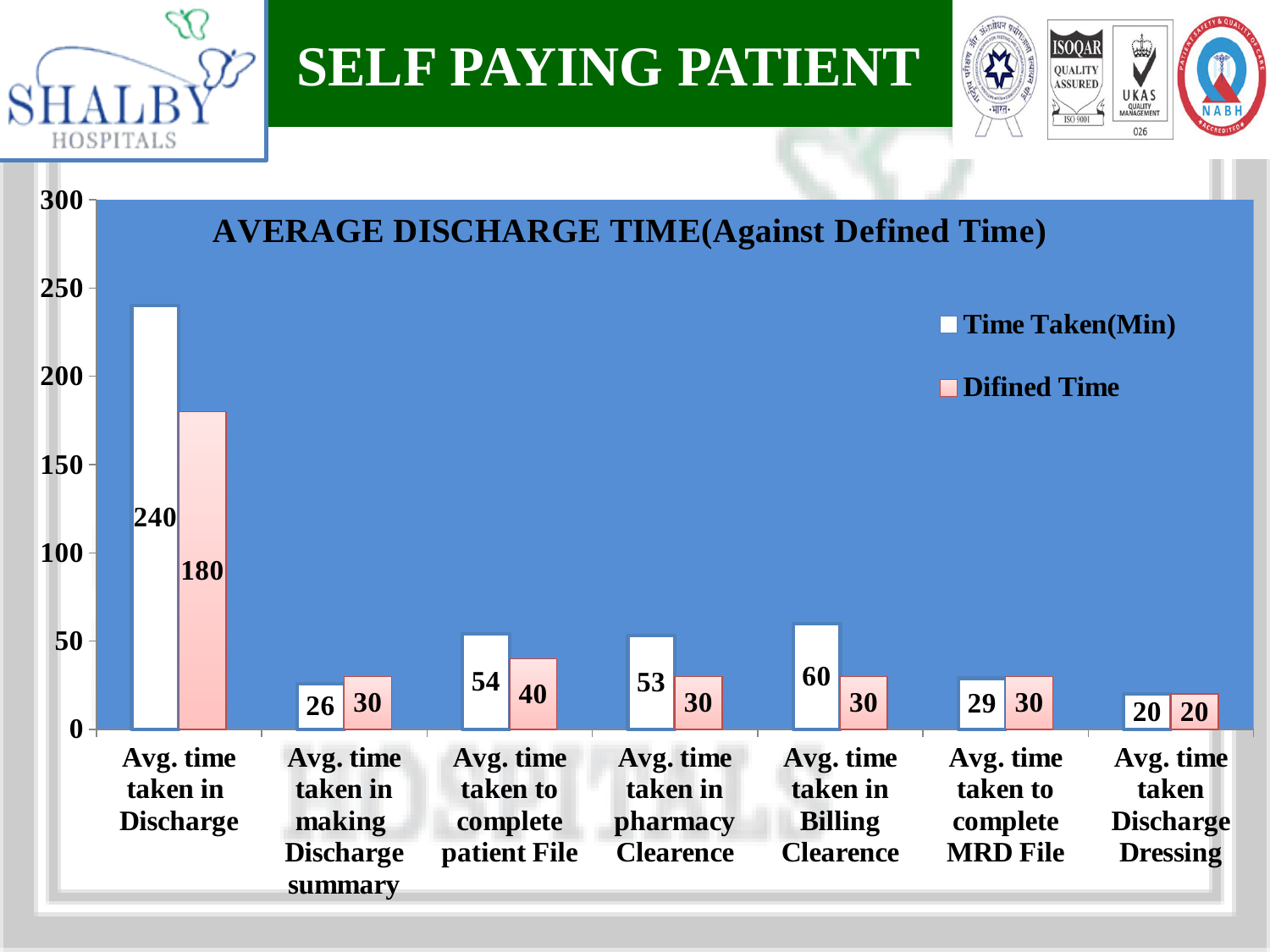
What kind of chart is shown on the slide? Bar chart What is the Time Taken(Min) value for Avg. time taken in Discharge? 240 Which category has the lowest Difined Time value? Avg. time taken Discharge Dressing What is the Time Taken(Min) value for Avg. time taken in Billing Clearence? 60 How many series does the legend list? 2 For Avg. time taken in making Discharge summary, which is larger: Time Taken(Min) or Difined Time? Difined Time What is the Difined Time value for Avg. time taken to complete patient File? 40 Which category has the highest Time Taken(Min) value? Avg. time taken in Discharge What is the difference between Time Taken(Min) and Difined Time for Avg. time taken in Discharge? 60 What is the title of the chart? AVERAGE DISCHARGE TIME(Against Defined Time) How many categories are shown on the x axis? 7 What is the difference between Time Taken(Min) and Difined Time for Avg. time taken in Billing Clearence? 30